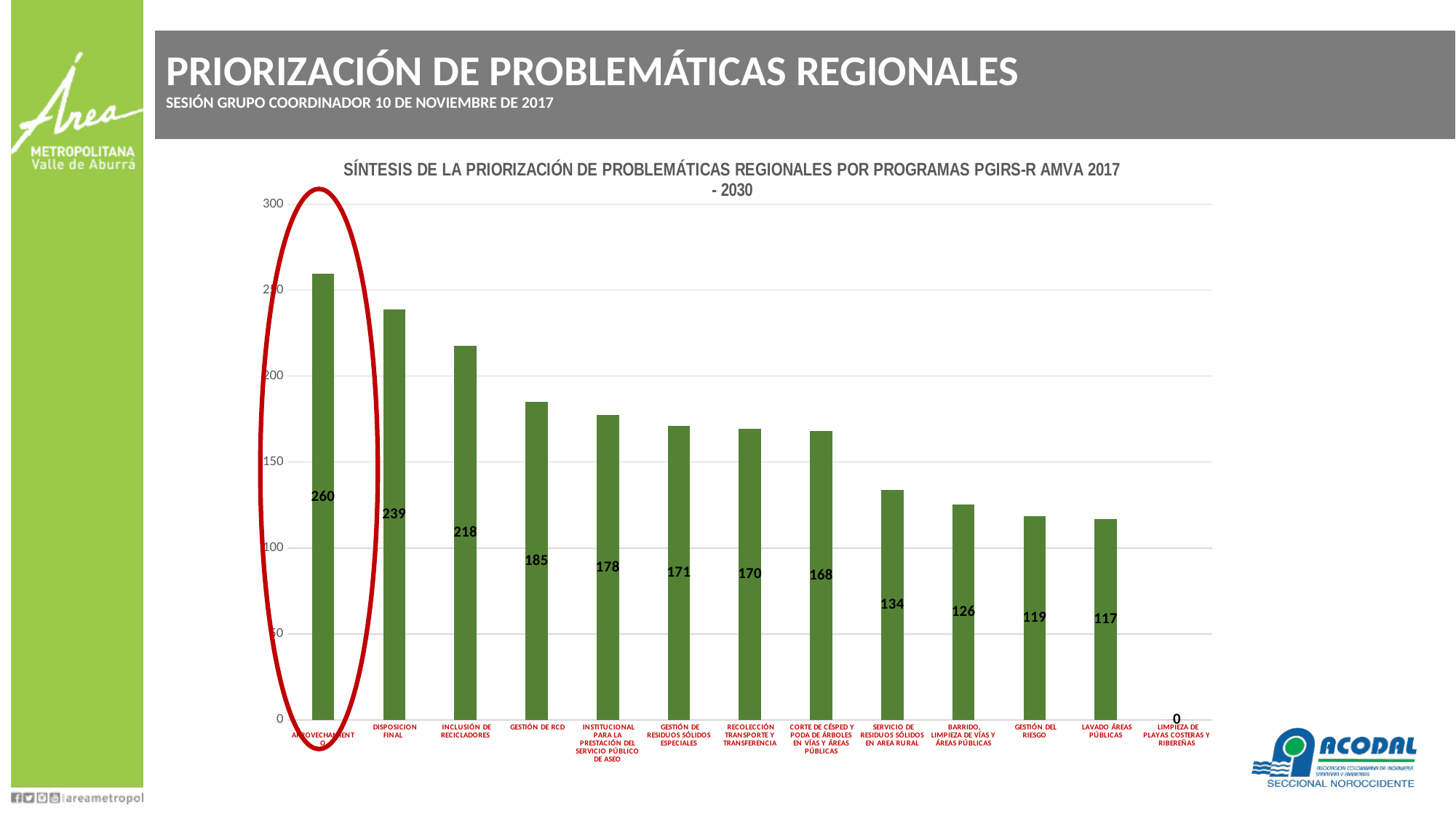
Is the value for SERVICIO DE RESIDUOS SÓLIDOS EN AREA RURAL greater or less than 150? less What is the value for DISPOSICION FINAL? 239 Which is larger, the value for INCLUSIÓN DE RECICLADORES or the value for GESTIÓN DEL RIESGO? INCLUSIÓN DE RECICLADORES Do the values rise or fall from left to right along the x axis? fall How many categories are shown on the x axis? 13 What is the value for LIMPIEZA DE PLAYAS COSTERAS Y RIBEREÑAS? 0 What is the value for GESTIÓN DE RCD? 185 What is the difference between the values for APROVECHAMIENTO and DISPOSICION FINAL? 21 Which category has the highest value? APROVECHAMIENTO Which category has the lowest value? LIMPIEZA DE PLAYAS COSTERAS Y RIBEREÑAS What is the value for LAVADO ÁREAS PÚBLICAS? 117 What kind of chart is shown on the slide? bar chart